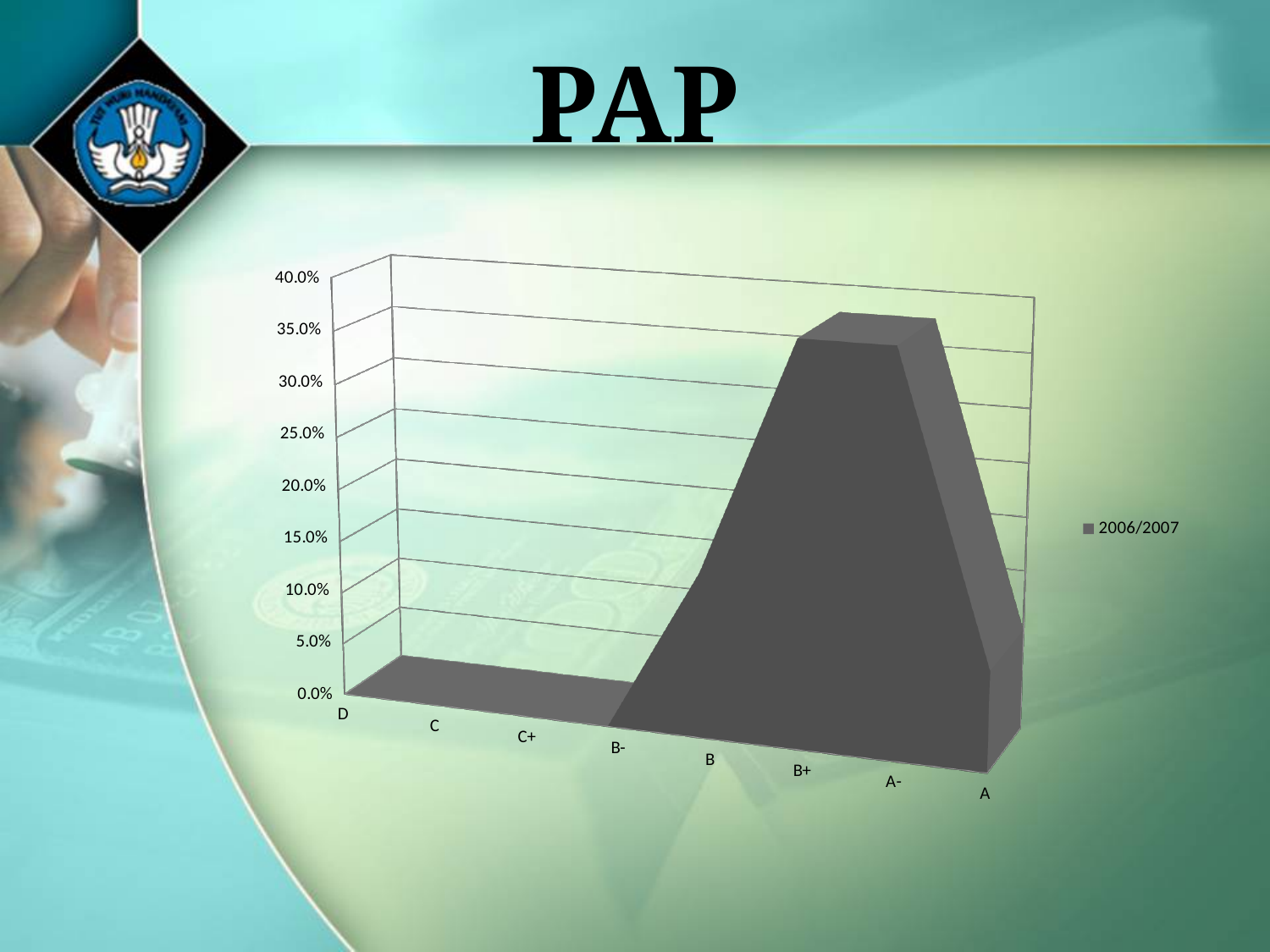
Do the values rise or fall from A- to A? fall What kind of chart is shown on the slide? area chart Do the values rise or fall from B- to B+? rise What is the title of the slide containing the chart? PAP Is the value for C+ greater or less than 5.0%? less Which is larger, the value for B+ or the value for C? B+ What series name is shown in the legend? 2006/2007 Is the value for B+ greater or less than 25.0%? greater Is the value for A- greater or less than 20.0%? greater How many series does the legend list? 1 How many grade categories are shown on the x axis? 8